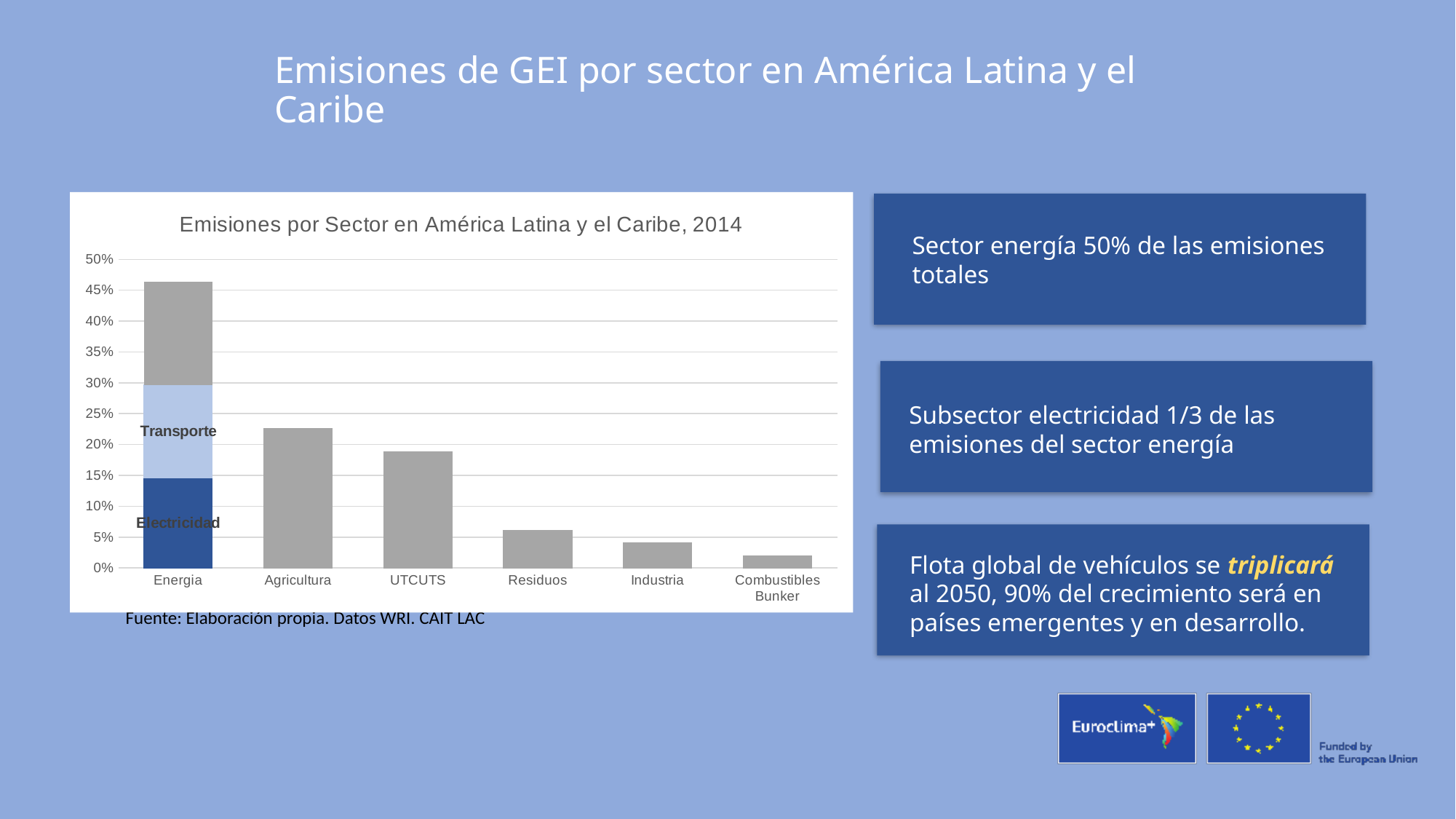
How many sector categories are shown on the x axis of the chart? 6 What is the title of the chart? Emisiones por Sector en América Latina y el Caribe, 2014 Which sector has the lowest emissions share in the chart? Combustibles Bunker Is the value for Energia greater or less than 40%? greater Which sector has the highest emissions share in the chart? Energia Which has a larger emissions share, Agricultura or UTCUTS? Agricultura Is the value for Agricultura greater or less than 25%? less Do the bar values rise or fall moving from left to right along the x axis? fall What are the two labelled subsectors shown within the Energia bar? Electricidad and Transporte What kind of chart is shown on the slide? bar chart Which has a larger emissions share, Residuos or Industria? Residuos Is the value for Industria greater or less than 5%? less